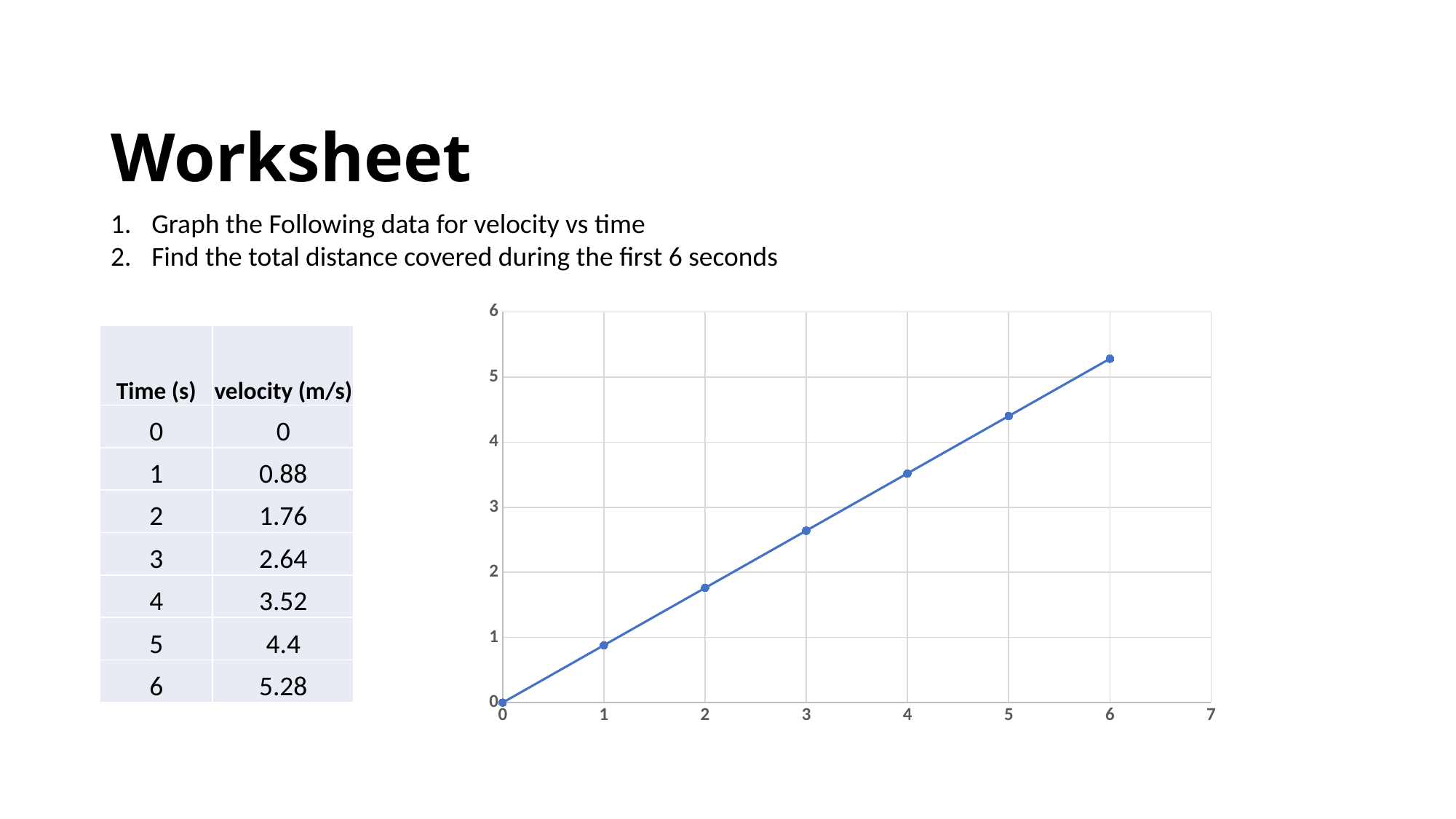
What is the highest value labelled on the chart's vertical axis? 6 According to the table on the slide, what is the velocity (m/s) at time 5 s? 4.4 According to the table on the slide, what is the velocity (m/s) at time 2 s? 1.76 What kind of chart is shown on the slide? line chart Is the plotted value at time 3 s greater or less than 2? greater Is the plotted value at time 4 s greater or less than 4? less Which is larger, the plotted value at time 5 s or at time 2 s? time 5 s Is the plotted value at time 6 s greater or less than 5? greater Do the plotted values rise or fall as time increases along the x axis? rise At which time (s) is the plotted velocity highest? 6 How many data points are plotted on the chart? 7 At which time (s) is the plotted velocity lowest? 0